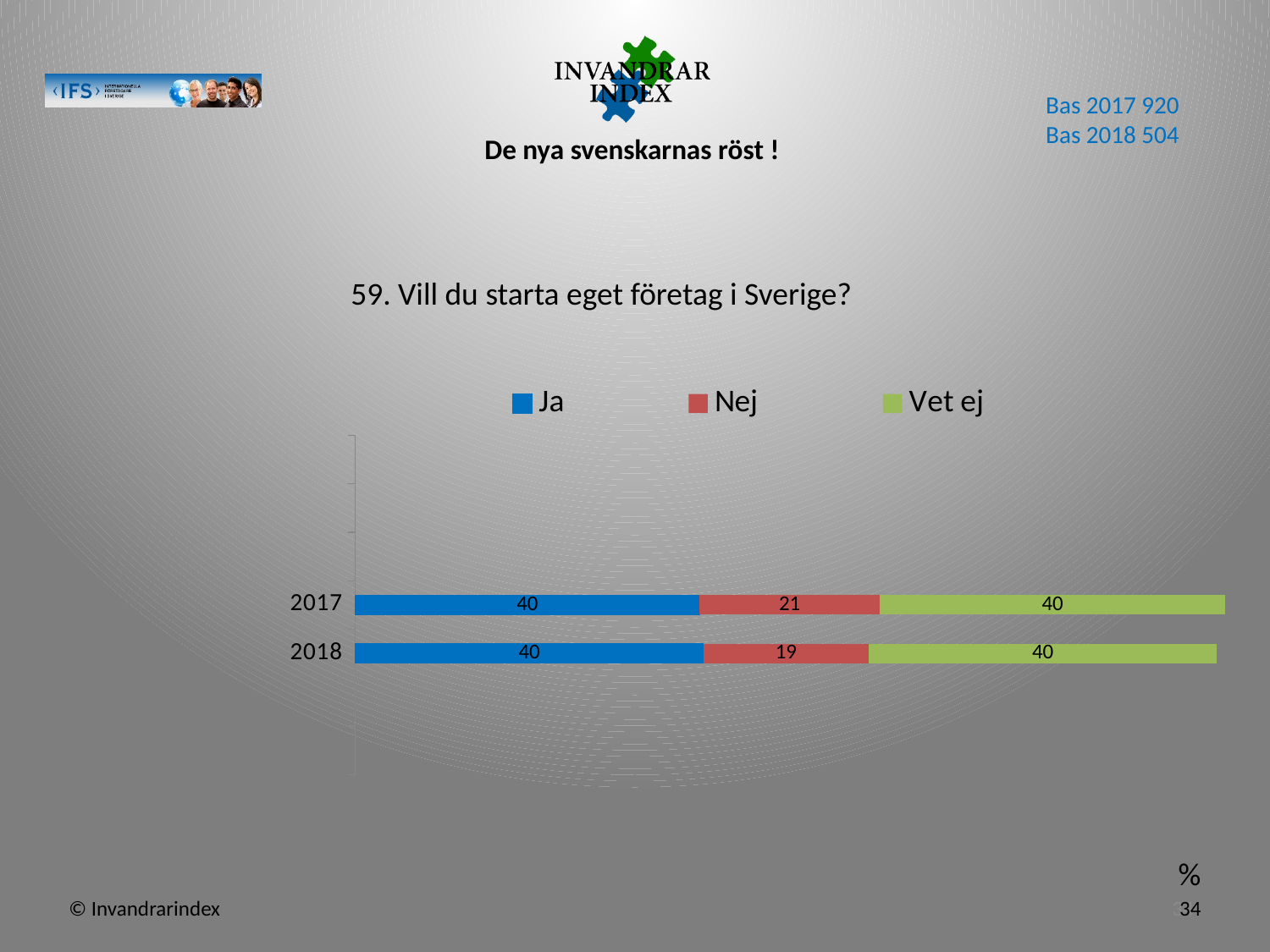
What is the difference between the Nej values for 2017 and 2018? 2 How many categories (years) are shown on the chart? 2 What is the value for Nej in 2017? 21 How many series does the legend list? 3 Which year has the larger Nej value, 2017 or 2018? 2017 What is the title of the chart? 59. Vill du starta eget företag i Sverige? What is the value for Ja in 2017? 40 What kind of chart is shown on the slide? Stacked bar chart What is the total of the stacked bar for 2018? 99 What is the value for Nej in 2018? 19 What is the value for Vet ej in 2017? 40 What is the total of the stacked bar for 2017? 101